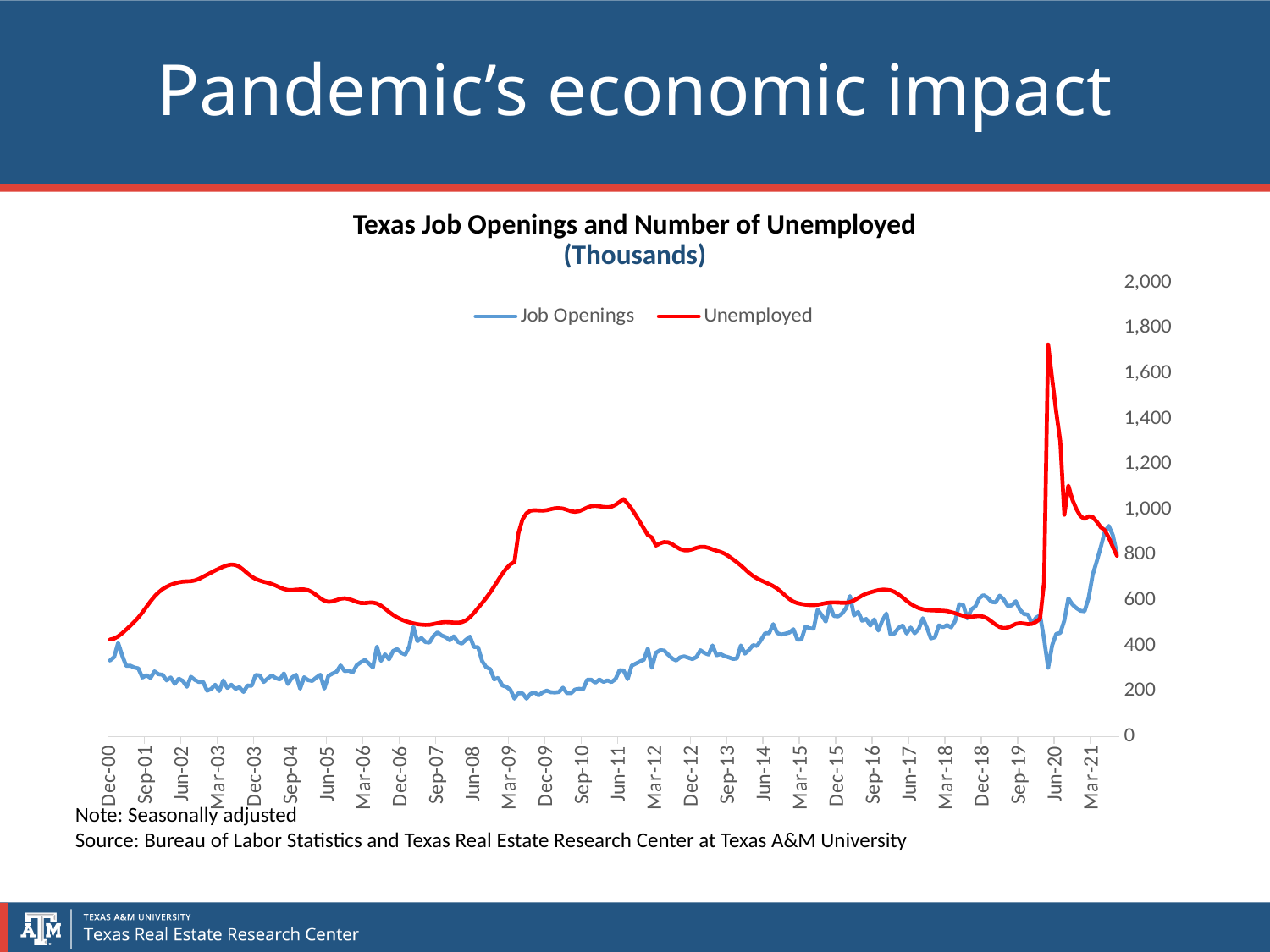
Which series is drawn in red? Unemployed Is the peak value of the Unemployed series around Jun-20 greater or less than 1,400? greater Is the value of Unemployed at Dec-09 greater or less than 800? greater What is the title of the chart? Texas Job Openings and Number of Unemployed (Thousands) What kind of chart is shown on the slide? Line chart Which series reaches the highest value anywhere on the chart? Unemployed At Dec-09, which series has the larger value, Job Openings or Unemployed? Unemployed Is the value of Job Openings at Dec-09 greater or less than 400? less How many series does the legend list? 2 Does the Unemployed series rise or fall between Mar-09 and Dec-09? Rise